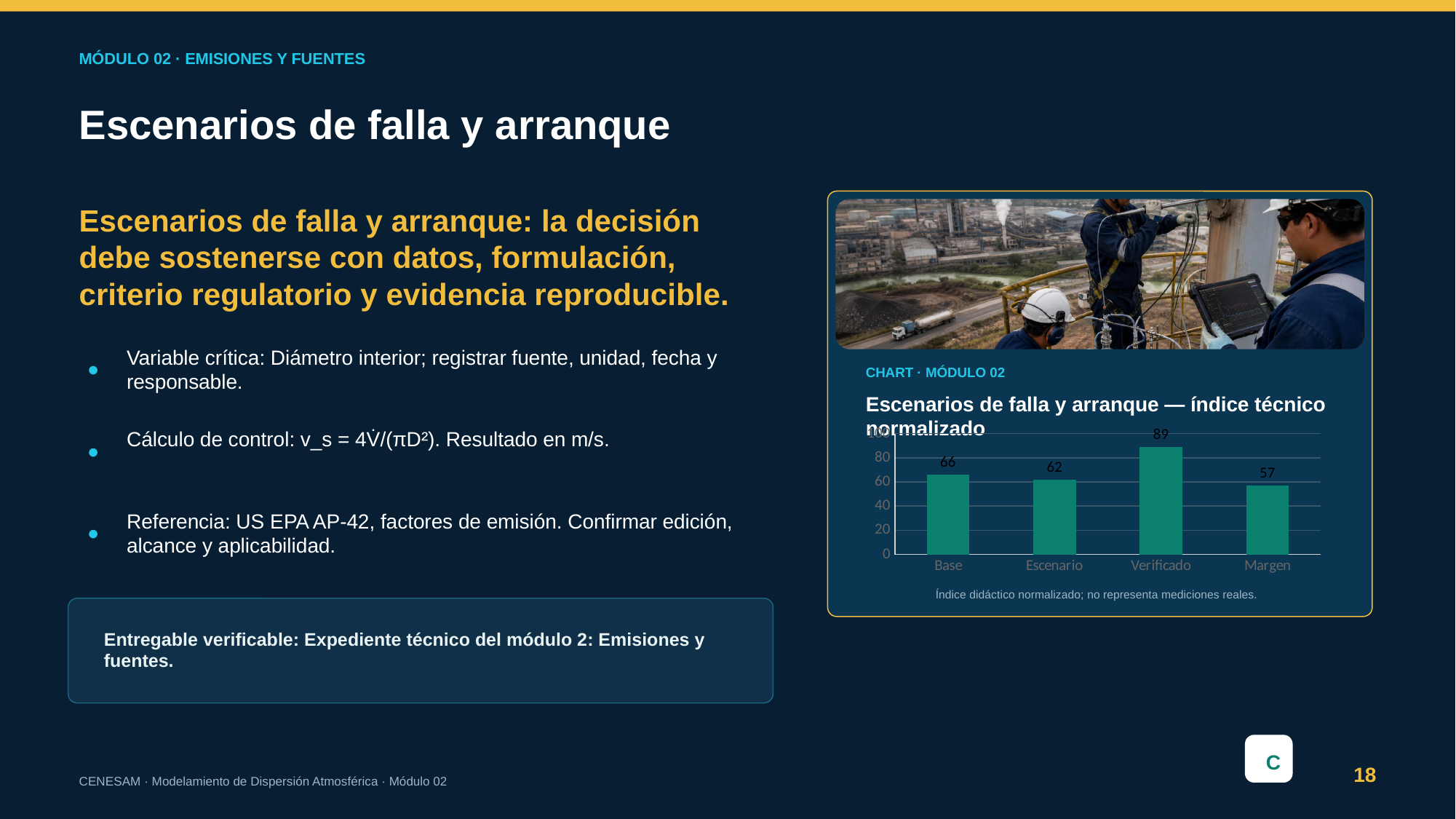
What is the difference between the values for Verificado and Margen? 32 Which category has the lowest value? Margen Which is larger, the value for Base or the value for Margen? Base What is the value for Margen? 57 What is the difference between the values for Base and Escenario? 4 What is the value for Escenario? 62 What is the value for Base? 66 What kind of chart is shown? Bar chart What is the value for Verificado? 89 Which category has the highest value? Verificado How many categories are shown on the x axis? 4 Is the value for Verificado greater or less than 80? greater